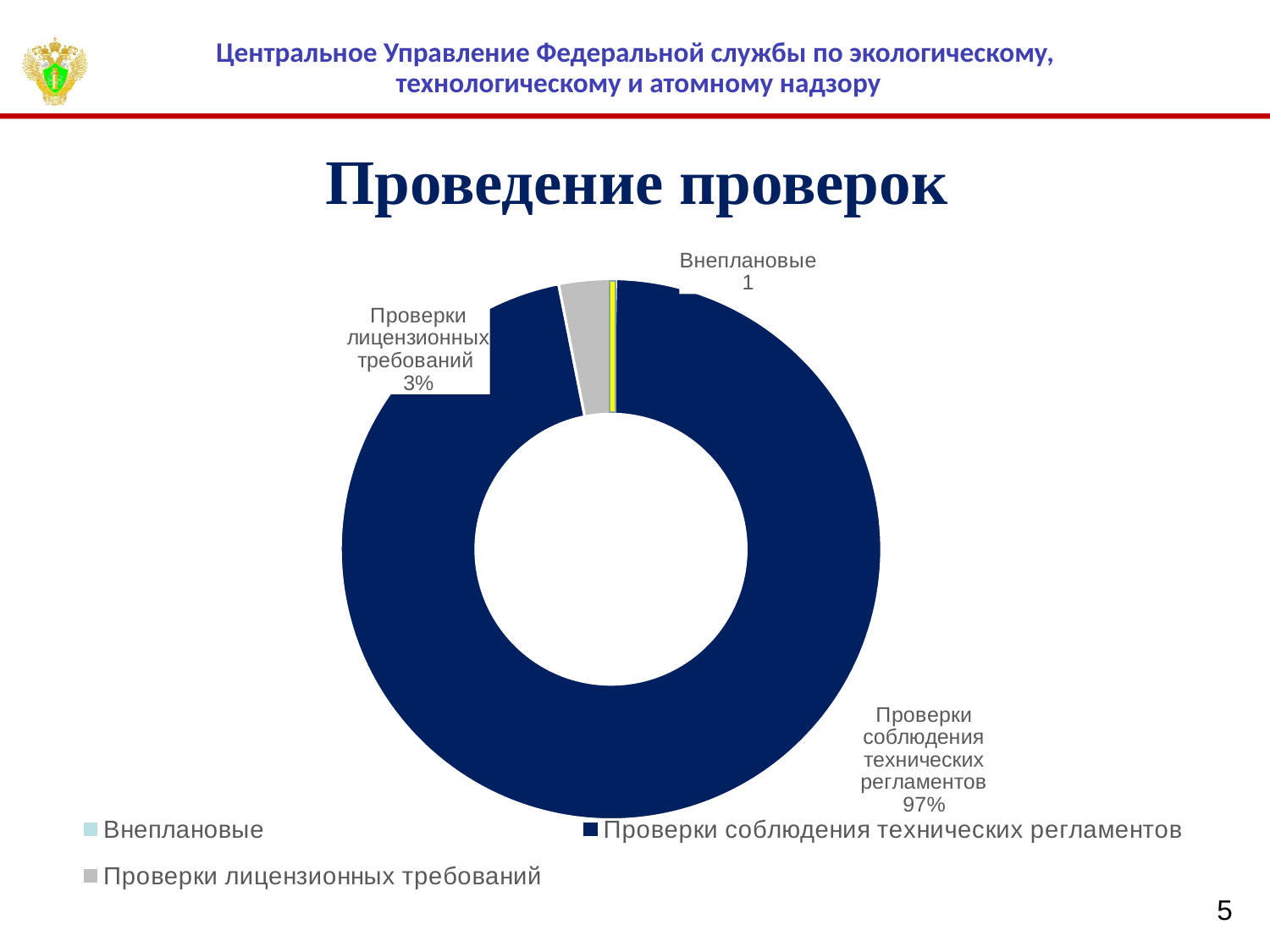
What colour is the slice for Проверки соблюдения технических регламентов? Dark blue What kind of chart is shown on the slide? Doughnut (pie) chart What is the difference in percentage points between Проверки соблюдения технических регламентов and Проверки лицензионных требований? 94 percentage points What share of the chart is labelled for Проверки лицензионных требований? 3% What share of the chart is labelled for Проверки соблюдения технических регламентов? 97% How many entries does the legend list? 3 What is the title of the chart on the slide? Проведение проверок How many categories are shown in the chart? 3 Which category has the largest slice of the chart? Проверки соблюдения технических регламентов Which is larger: the slice for Проверки лицензионных требований or the slice for Проверки соблюдения технических регламентов? Проверки соблюдения технических регламентов What value is printed on the data label for Внеплановые? 1 Which category has the smallest slice of the chart? Внеплановые